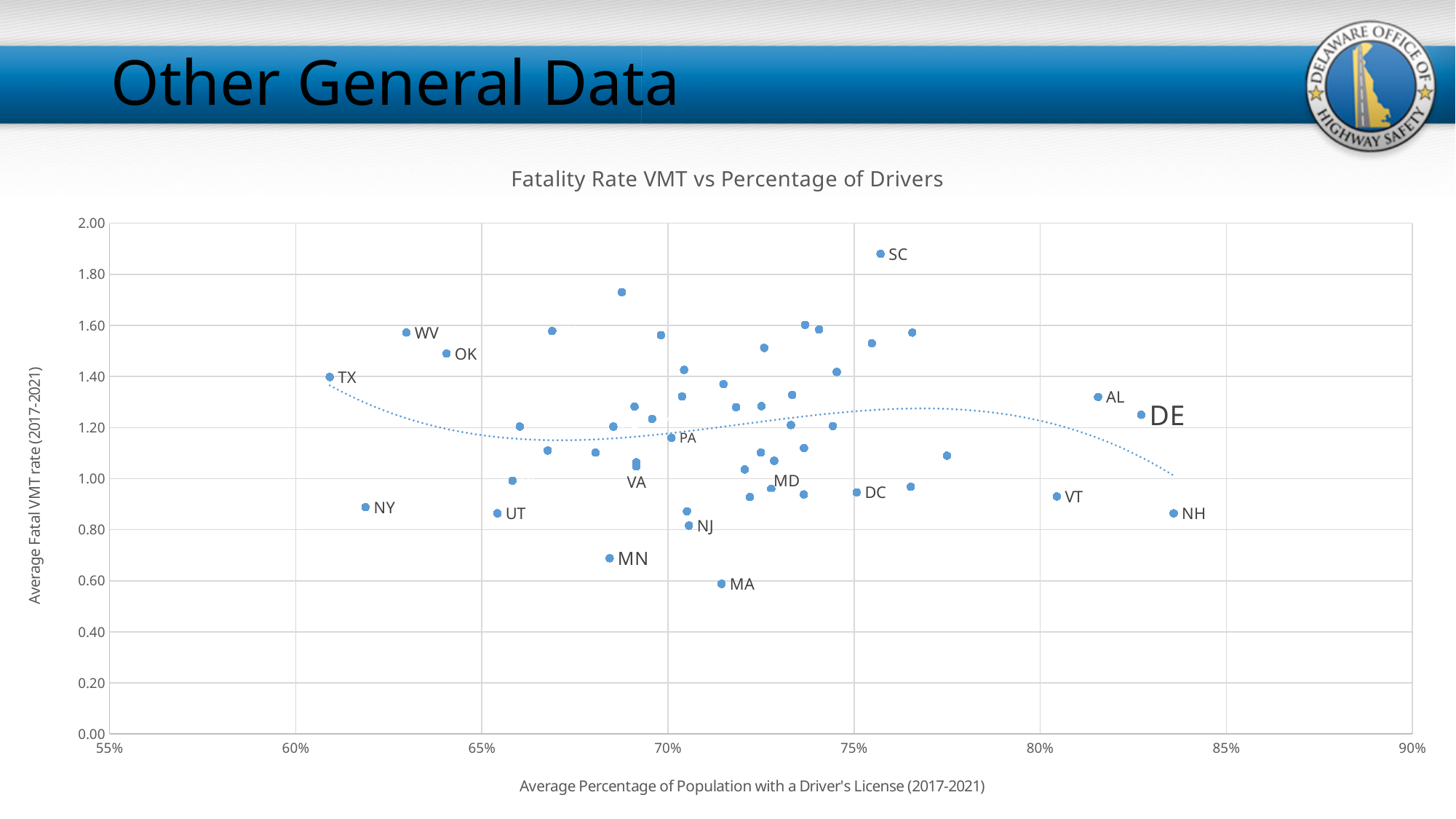
What is the label of the x axis of the chart? Average Percentage of Population with a Driver's License (2017-2021) Is the Average Fatal VMT rate for MA greater or less than 0.80? less What is the title of the chart? Fatality Rate VMT vs Percentage of Drivers Which labeled state has the lowest Average Fatal VMT rate? MA Is the Average Fatal VMT rate for SC greater or less than 1.80? greater What kind of chart is shown on the slide? scatter chart Is the Average Fatal VMT rate for MN greater or less than 0.80? less Which labeled state has the highest Average Fatal VMT rate? SC Which has a higher Average Fatal VMT rate, WV or OK? WV Which has a higher Average Fatal VMT rate, DE or NH? DE